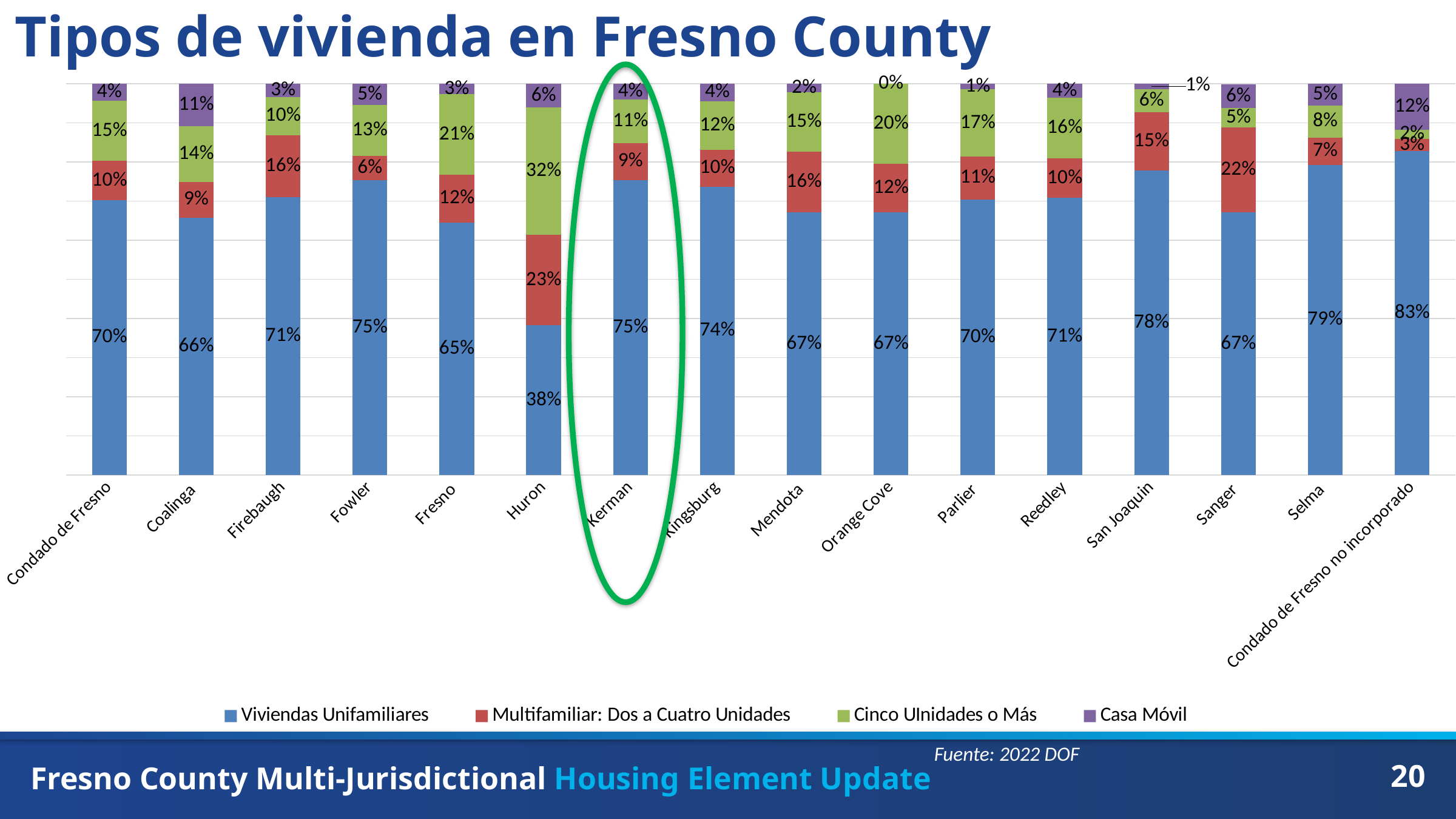
What is the difference between the Viviendas Unifamiliares values for Selma and Sanger? 12% What is the Viviendas Unifamiliares value for Huron? 38% What is the Casa Móvil value for Coalinga? 11% Which jurisdiction has the highest Cinco UInidades o Más share? Huron Which jurisdiction has the lowest Viviendas Unifamiliares share? Huron What is the Cinco UInidades o Más value for Fresno? 21% How many series does the legend list? 4 How many categories (jurisdictions) are shown on the x axis? 16 Which jurisdiction has the highest Viviendas Unifamiliares share? Condado de Fresno no incorporado Which jurisdiction's bar is circled in green on the slide? Kerman What type of chart is shown on the slide? Stacked bar chart Which has a larger Multifamiliar: Dos a Cuatro Unidades share, Sanger or Firebaugh? Sanger